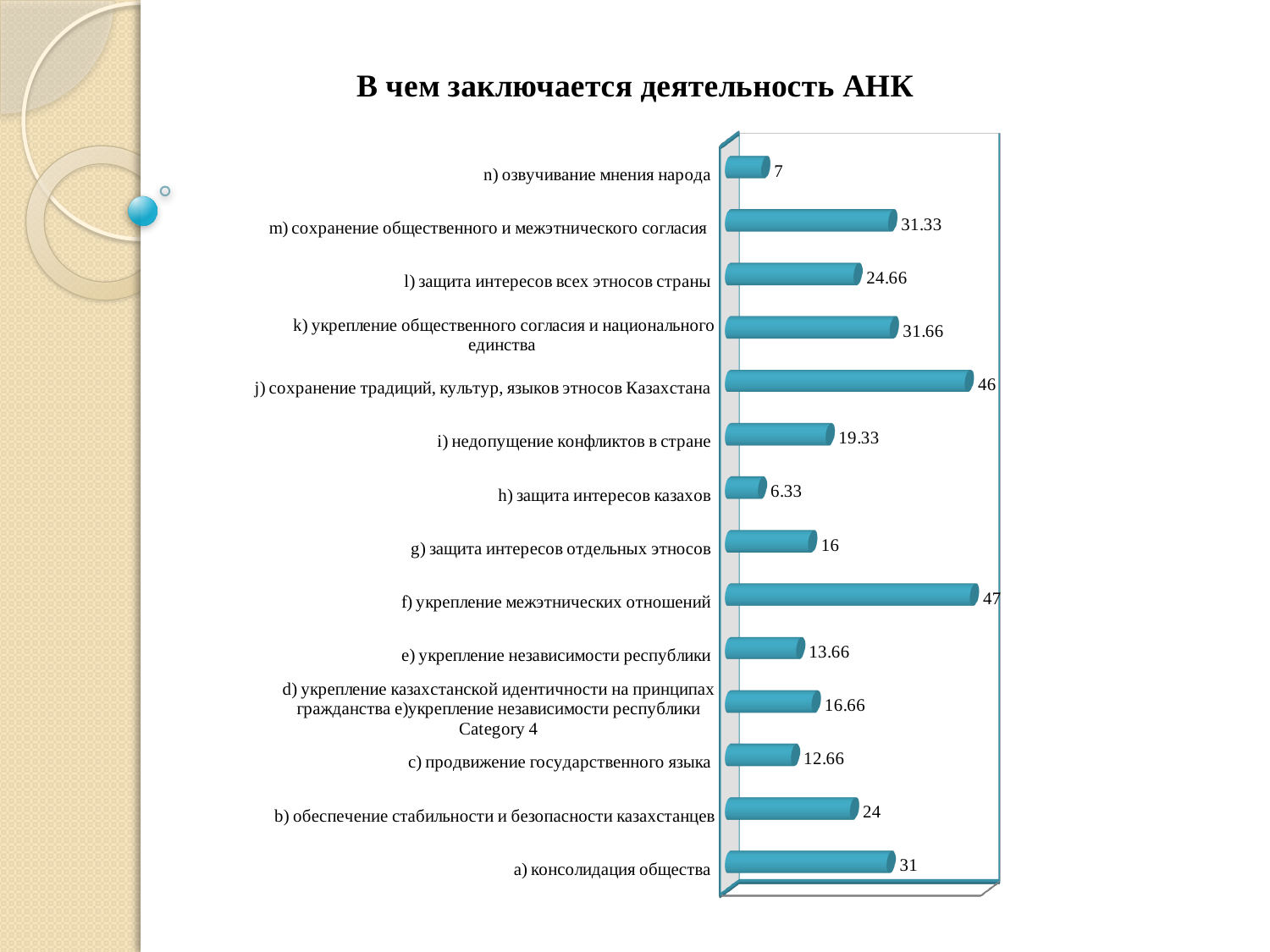
What value is shown for "j) сохранение традиций, культур, языков этносов Казахстана"? 46 What value is shown for "c) продвижение государственного языка"? 12.66 Which has a larger value: "g) защита интересов отдельных этносов" or "e) укрепление независимости республики"? g) защита интересов отдельных этносов What value is shown for "a) консолидация общества"? 31 Which category has the highest value? f) укрепление межэтнических отношений Which has a larger value: "b) обеспечение стабильности и безопасности казахстанцев" or "l) защита интересов всех этносов страны"? l) защита интересов всех этносов страны What type of chart is shown on the slide? Bar chart What is the difference between the values for "f) укрепление межэтнических отношений" and "j) сохранение традиций, культур, языков этносов Казахстана"? 1 Which category has the lowest value? h) защита интересов казахов What is the difference between the values for "m) сохранение общественного и межэтнического согласия" and "a) консолидация общества"? 0.33 What value is shown for "i) недопущение конфликтов в стране"? 19.33 How many categories are plotted in the chart? 14